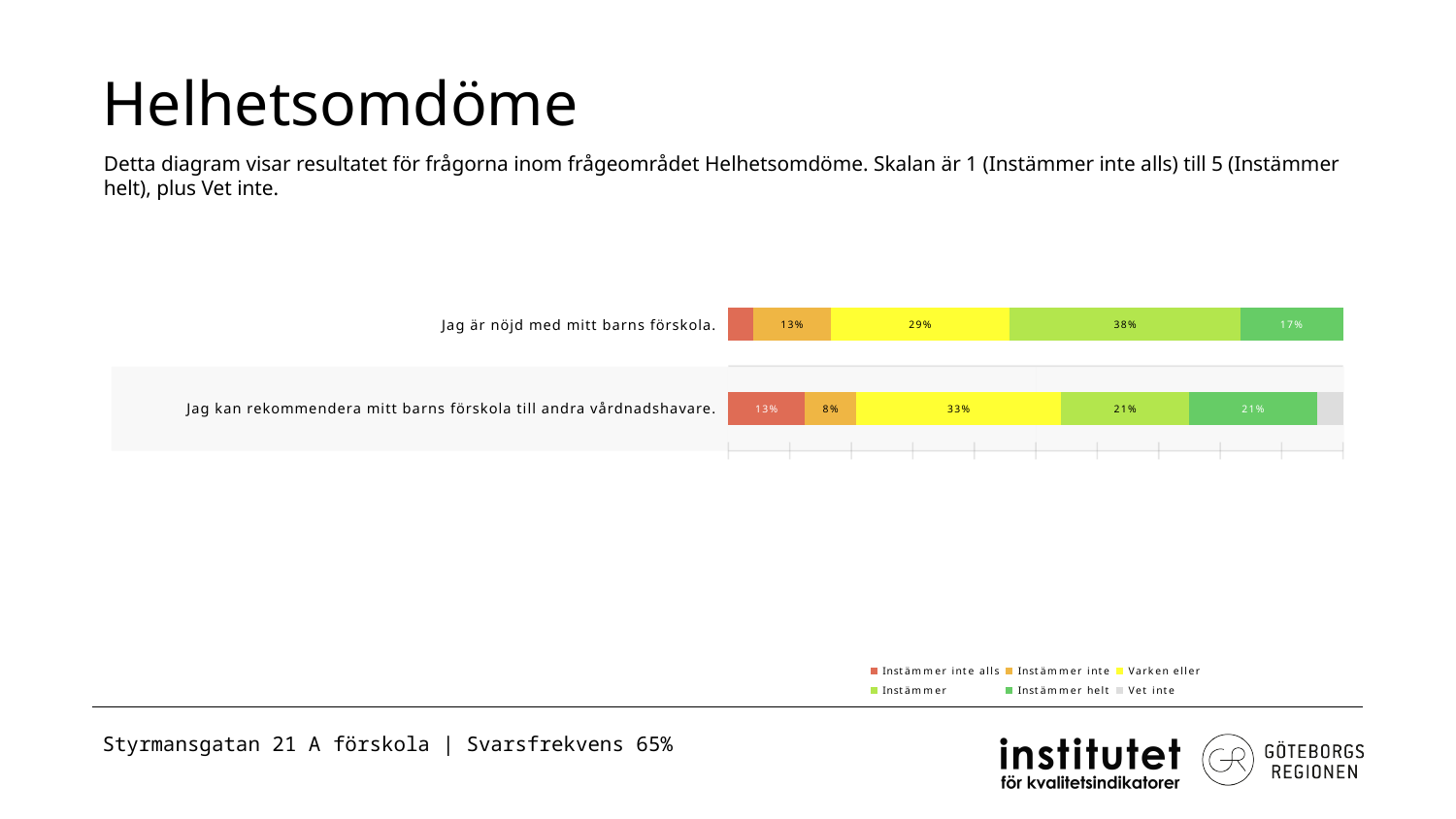
What is the 'Instämmer inte alls' value for 'Jag kan rekommendera mitt barns förskola till andra vårdnadshavare.'? 13% How many categories (statements) are plotted in the chart? 2 What is the difference between the 'Instämmer inte' values of the two statements (13% and 8%)? 5 percentage points Which statement has the larger 'Instämmer' share: 'Jag är nöjd med mitt barns förskola.' or 'Jag kan rekommendera mitt barns förskola till andra vårdnadshavare.'? Jag är nöjd med mitt barns förskola. What kind of chart is shown on the slide? stacked bar chart What is the 'Instämmer' value for 'Jag är nöjd med mitt barns förskola.'? 38% What is the 'Instämmer helt' value for 'Jag är nöjd med mitt barns förskola.'? 17% What is the 'Instämmer inte' value for 'Jag är nöjd med mitt barns förskola.'? 13% Which legend entry is shown in grey? Vet inte What is the difference between the 'Instämmer' values of the two statements (38% and 21%)? 17 percentage points What is the 'Varken eller' value for 'Jag kan rekommendera mitt barns förskola till andra vårdnadshavare.'? 33% How many series does the legend list? 6